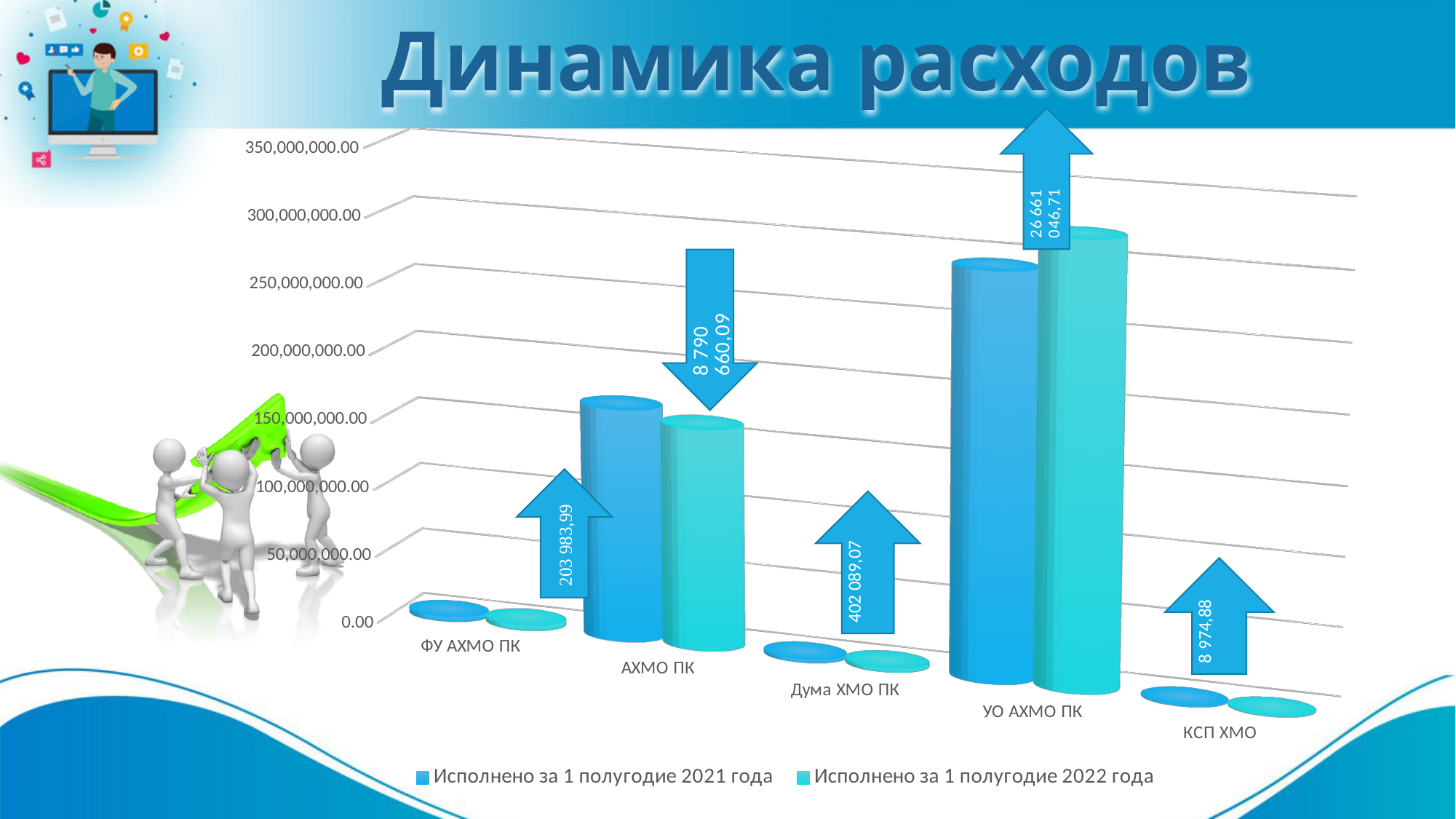
How many categories are shown on the x axis of the chart? 5 How many series does the chart legend list? 2 Is the value for АХМО ПК in the series 'Исполнено за 1 полугодие 2021 года' greater or less than 100,000,000.00? greater What is the title of the chart? Динамика расходов What kind of chart is shown on the slide? bar chart Which category has the highest values in the chart? УО АХМО ПК Is the value for УО АХМО ПК in the series 'Исполнено за 1 полугодие 2022 года' greater or less than 200,000,000.00? greater Which is larger: the value for УО АХМО ПК or for АХМО ПК in the series 'Исполнено за 1 полугодие 2022 года'? УО АХМО ПК Is the value for КСП ХМО in the series 'Исполнено за 1 полугодие 2022 года' greater or less than 50,000,000.00? less What is the name of the second series listed in the chart legend? Исполнено за 1 полугодие 2022 года For АХМО ПК, which series has the larger value: 'Исполнено за 1 полугодие 2021 года' or 'Исполнено за 1 полугодие 2022 года'? Исполнено за 1 полугодие 2021 года